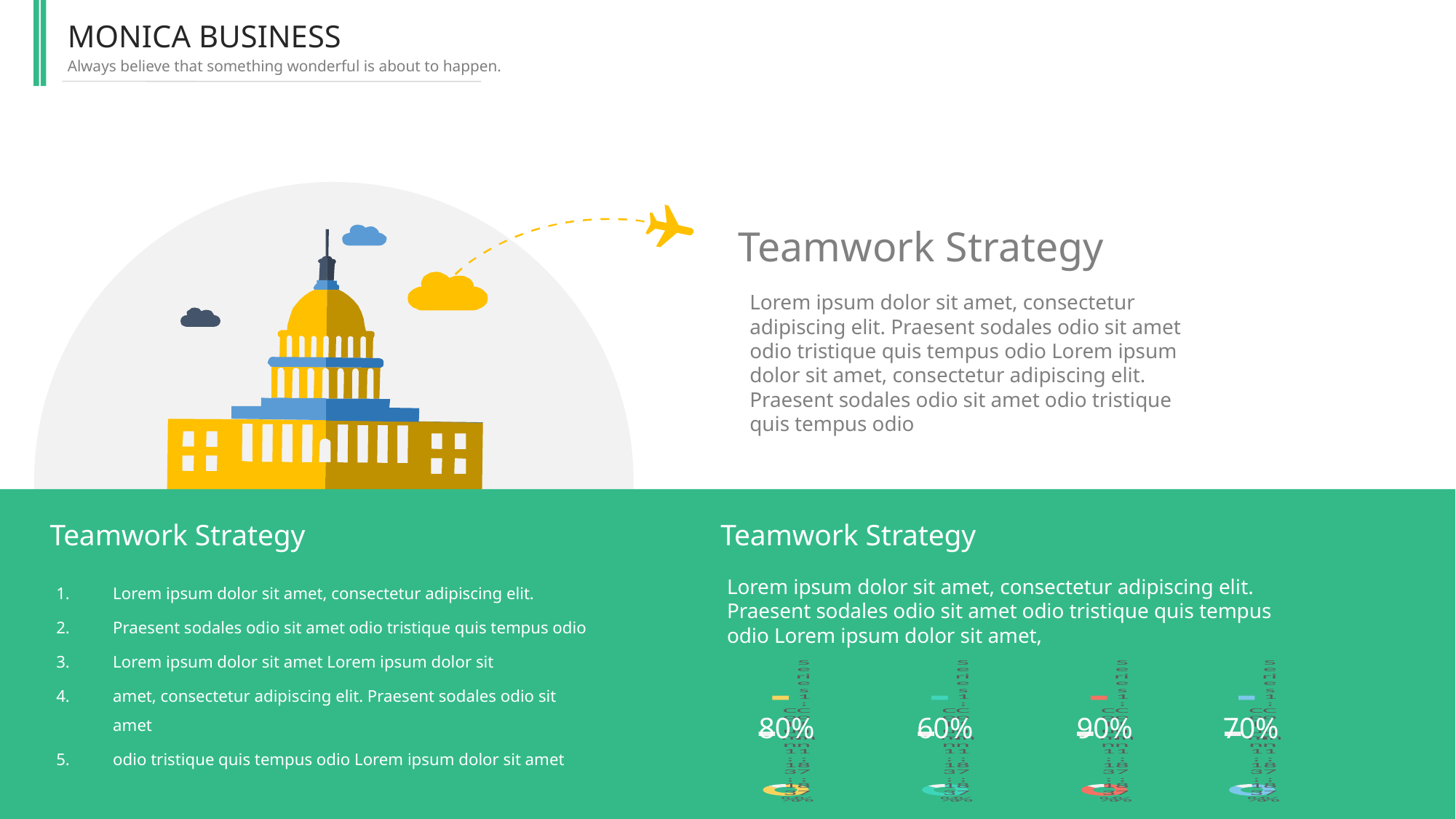
What kind of chart are the four small charts at the bottom right of the slide? Doughnut (pie) charts What colour is the ring of the leftmost small chart at the bottom right of the slide? Yellow How many small charts are shown at the bottom right of the slide? 4 Among the four small charts at the bottom right, which one shows the highest percentage? The third chart (90%) What is the difference between the percentage on the third small chart (90%) and the second small chart (60%)? 30% Which is larger: the percentage on the leftmost small chart or the rightmost small chart? The leftmost chart (80%) What percentage is shown on the third small chart from the left at the bottom right of the slide? 90% Among the four small charts at the bottom right, which one shows the lowest percentage? The second chart (60%) What percentage is shown on the second small chart from the left at the bottom right of the slide? 60% What percentage is shown on the rightmost small chart at the bottom right of the slide? 70% What colour is the ring of the third small chart from the left at the bottom right of the slide? Red What percentage is shown on the leftmost small chart at the bottom right of the slide? 80%